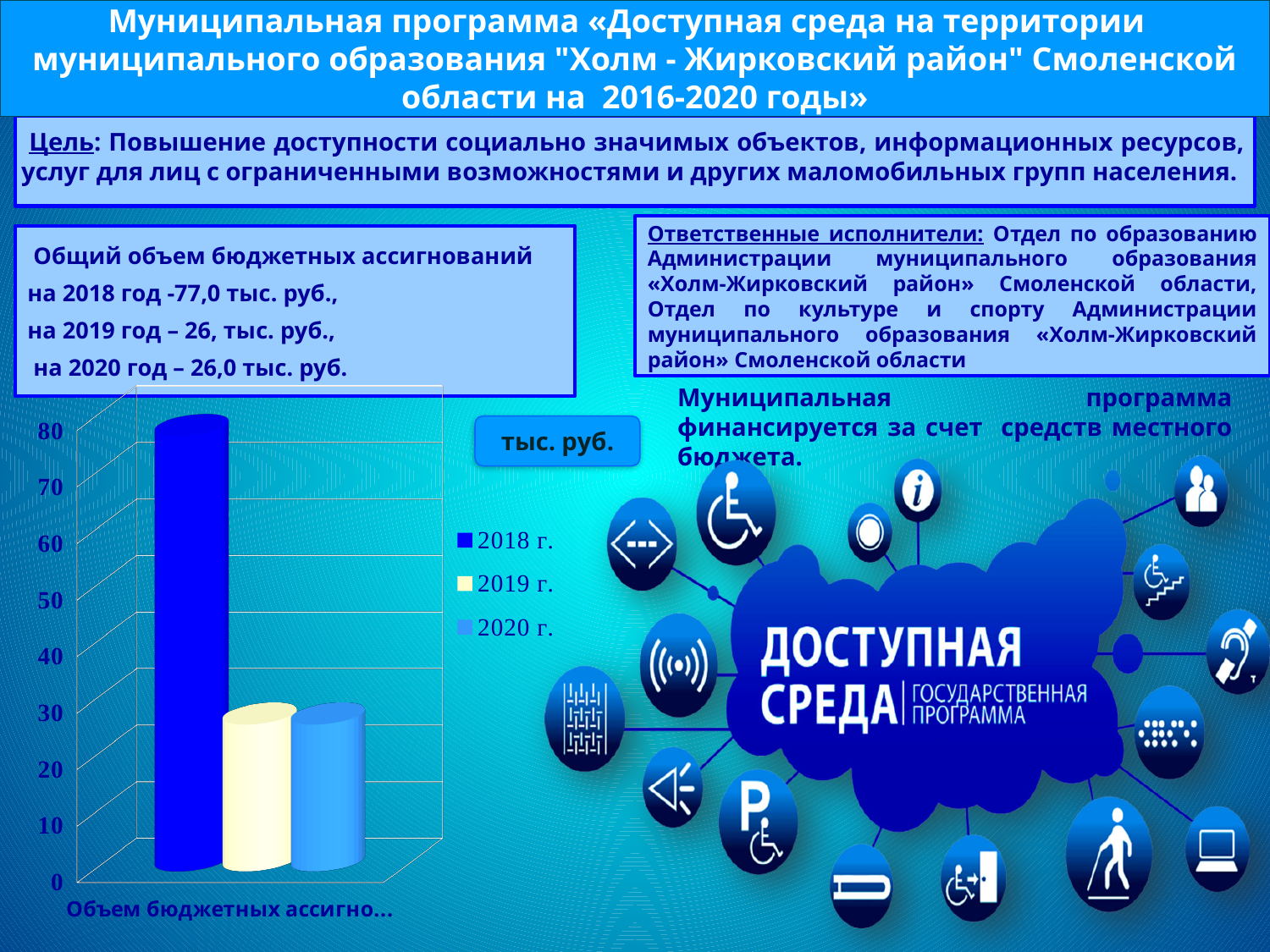
Is the value for 2020 г. greater or less than 30? less Which is larger, the value for 2020 г. or the value for 2018 г.? 2018 г. Is the value for 2018 г. greater or less than 70? greater What kind of chart is shown on the slide? bar chart Is the value for 2018 г. greater or less than 80? less Which series has the highest bar in the chart? 2018 г. Which is larger, the value for 2018 г. or the value for 2019 г.? 2018 г. How many bars are plotted in the chart? 3 How many series does the chart legend list? 3 What are the entries in the chart legend? 2018 г., 2019 г., 2020 г. What unit is shown in the label box next to the chart? тыс. руб.